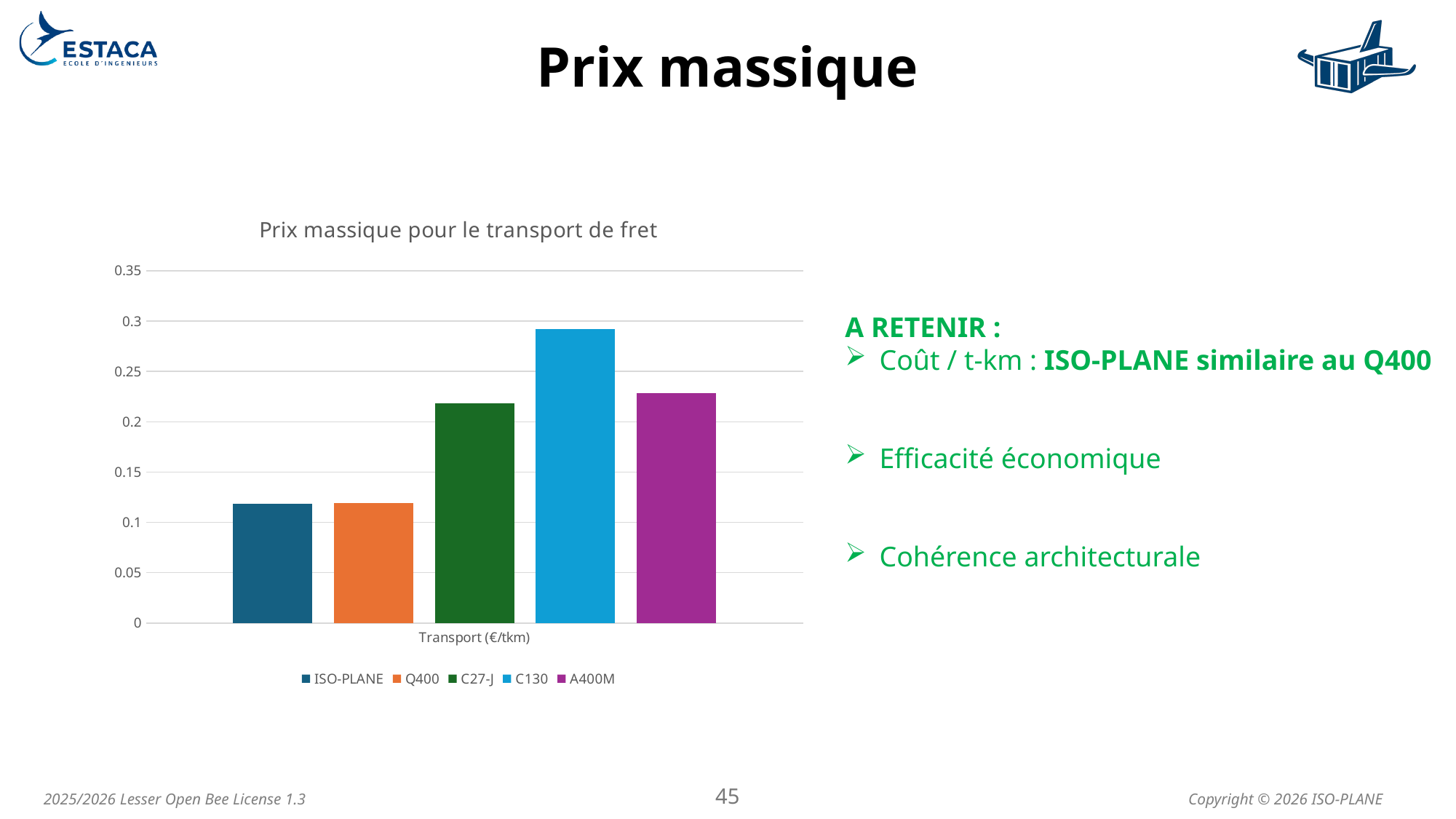
Is the value for A400M greater or less than 0.25? less Is the value for Q400 greater or less than 0.1? greater What kind of chart is shown on the slide? bar chart Which is larger, the value for C130 or the value for A400M? C130 How many series does the legend list? 5 What is the title of the chart? Prix massique pour le transport de fret Which series has the highest value in the chart? C130 Is the value for ISO-PLANE greater or less than 0.15? less Which is larger, the value for C27-J or the value for ISO-PLANE? C27-J What is the label of the category on the x axis? Transport (€/tkm)